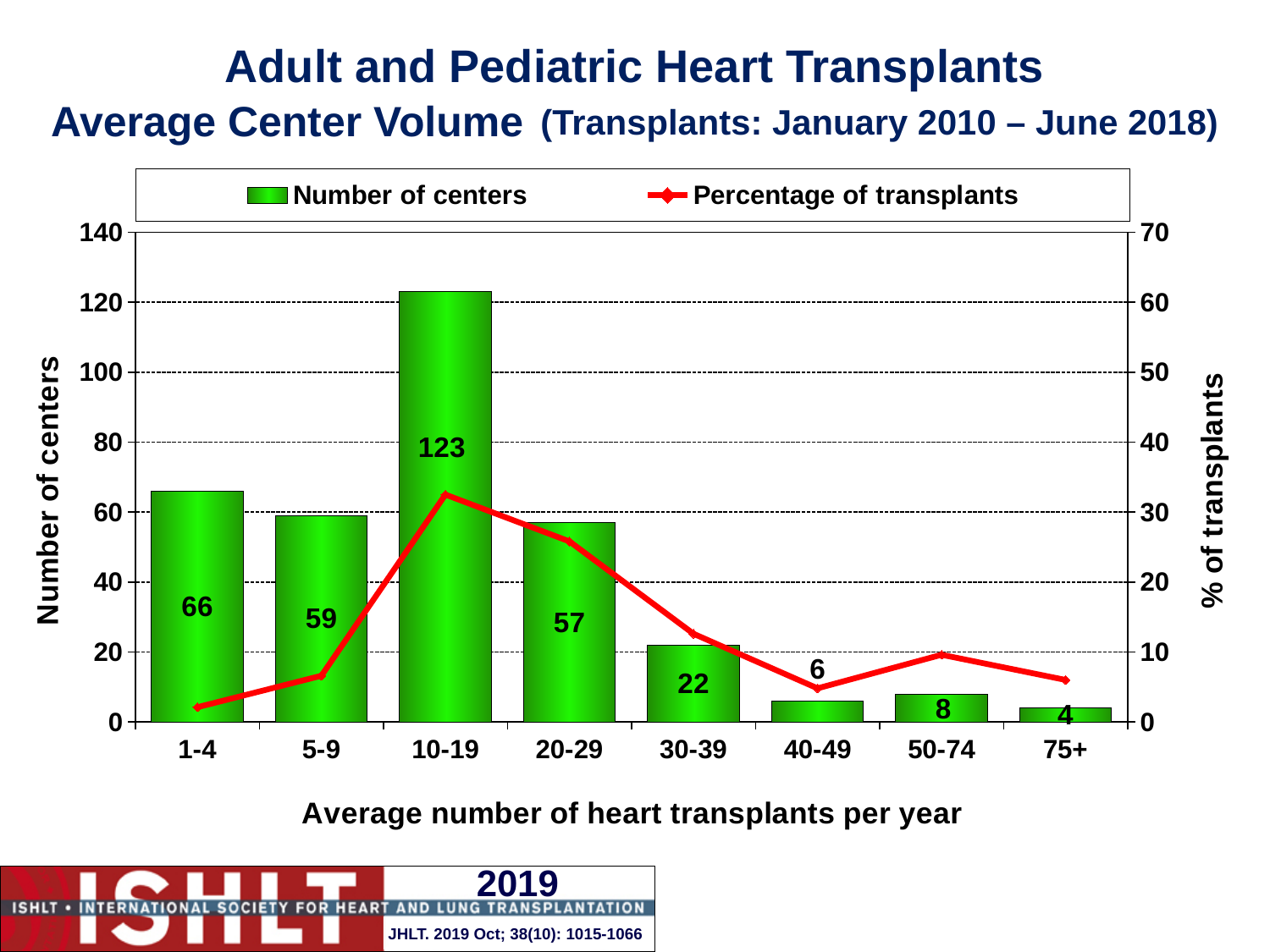
How many series does the legend list? 2 Which category has the highest number of centers? 10-19 What is the label of the left y axis? Number of centers Is the percentage of transplants for the 40-49 category greater or less than 10? less Is the percentage of transplants for the 10-19 category greater or less than 30? greater How many categories are shown on the x axis? 8 How many centers are in the 10-19 category? 123 How many centers are in the 1-4 category? 66 What is the difference in number of centers between the 10-19 and 20-29 categories? 66 How many centers are in the 75+ category? 4 Which has more centers, the 5-9 category or the 20-29 category? 5-9 Which category has the lowest number of centers? 75+